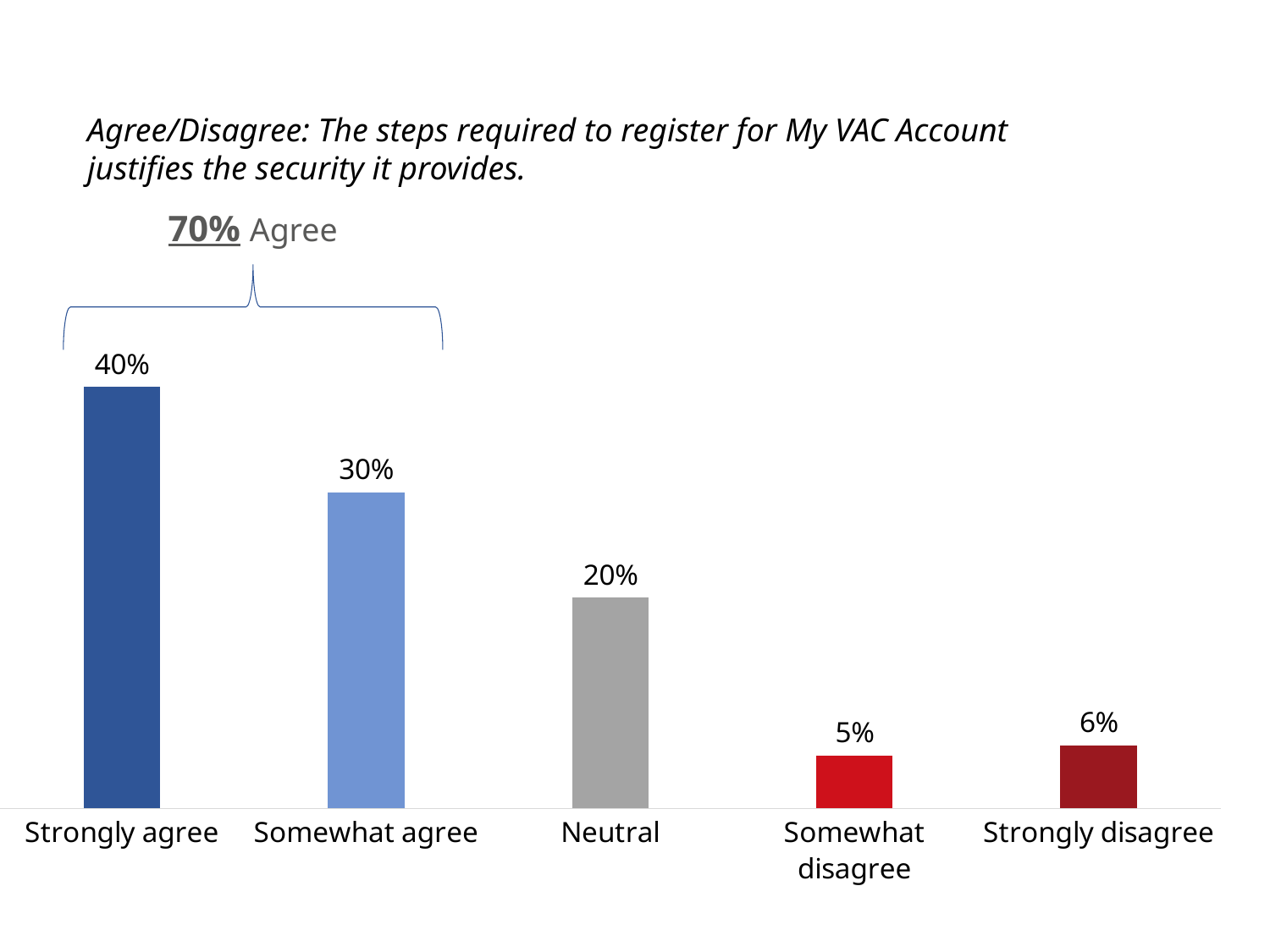
What is the value shown for Somewhat agree? 30% What is the value shown for Strongly disagree? 6% Which response category has the lowest value? Somewhat disagree What combined percentage of respondents agree, according to the annotation above the chart? 70% What percentage of respondents strongly agree that the steps required to register for My VAC Account justify the security it provides? 40% What kind of chart is shown on the slide? Bar chart What is the difference between the Strongly agree and Somewhat agree values? 10% What is the value shown for Somewhat disagree? 5% How many response categories are shown on the chart? 5 Which is larger, the value for Neutral or the value for Strongly disagree? Neutral What is the value shown for Neutral? 20% Which response category has the highest value? Strongly agree